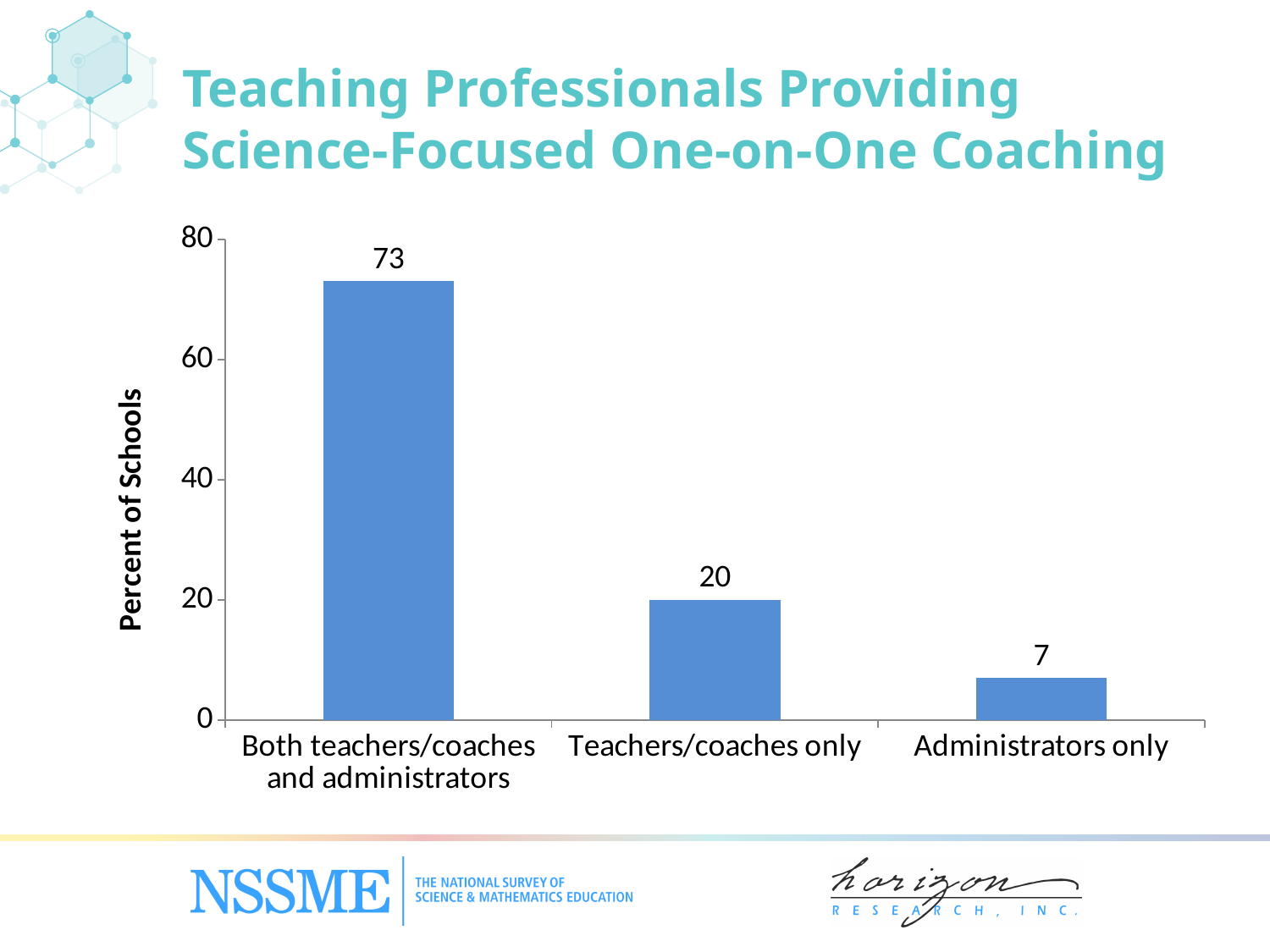
Is the value for Both teachers/coaches and administrators greater or less than 60? greater What is the value for Administrators only? 7 What percent of schools have both teachers/coaches and administrators providing science-focused one-on-one coaching? 73 What is the label of the vertical axis? Percent of Schools What kind of chart is shown on the slide? Bar chart Which is larger, the value for Teachers/coaches only or Administrators only? Teachers/coaches only Which category has the lowest percent of schools? Administrators only What is the difference between the values for Both teachers/coaches and administrators and Teachers/coaches only? 53 Which category has the highest percent of schools? Both teachers/coaches and administrators What is the difference between the values for Teachers/coaches only and Administrators only? 13 How many categories are shown on the chart? 3 What is the value for Teachers/coaches only? 20